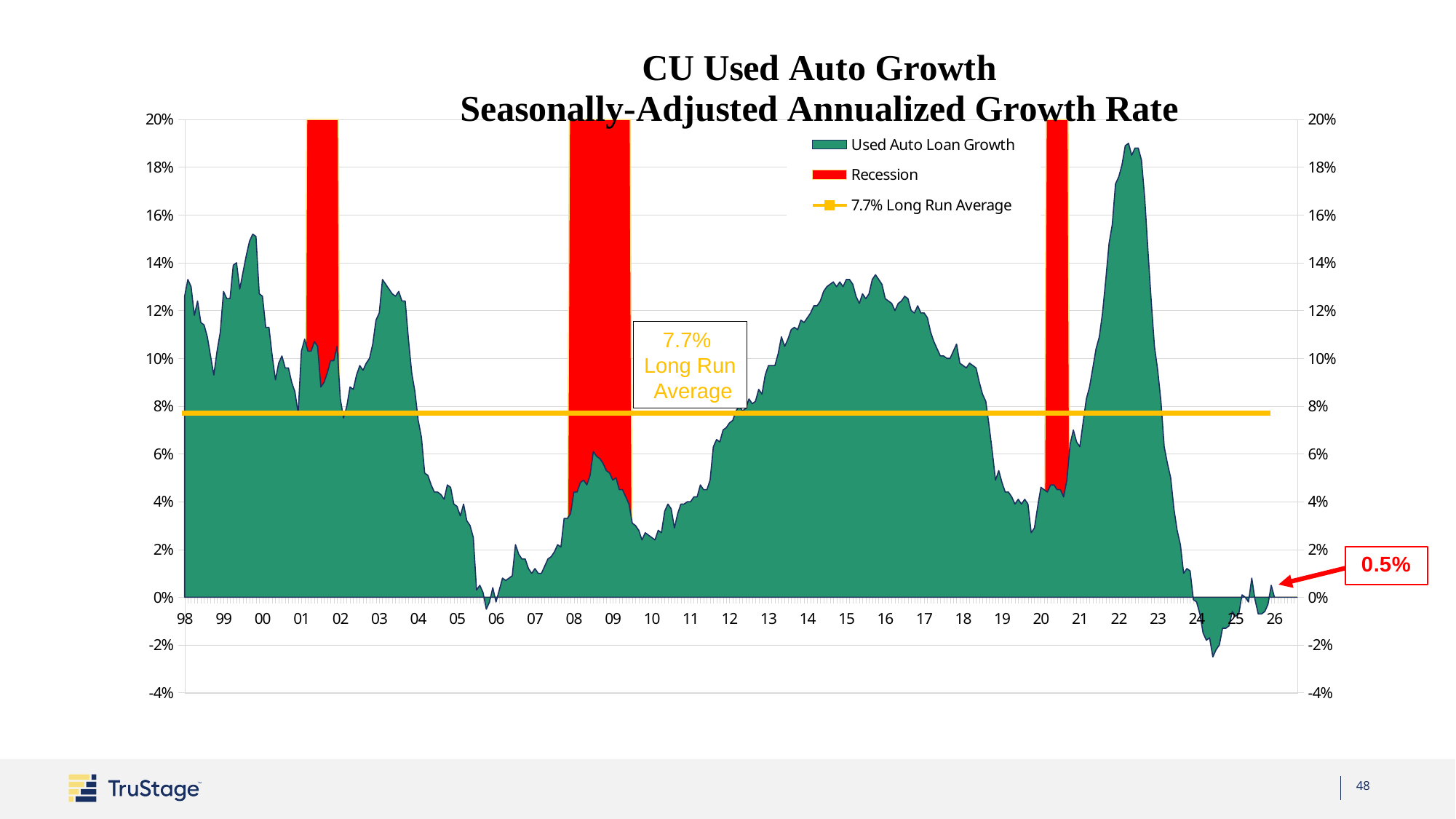
Is the lowest value of Used Auto Loan Growth in 2024 greater or less than 0%? less What kind of chart is used to show Used Auto Loan Growth? Area chart What is the most recent value labeled at the end of the Used Auto Loan Growth series? 0.5% Does Used Auto Loan Growth rise or fall between 2022 and 2024? Fall What is the long run average growth rate shown on the chart? 7.7% What is the title of the chart? CU Used Auto Growth Seasonally-Adjusted Annualized Growth Rate How many entries does the chart legend list? 3 In which year does Used Auto Loan Growth reach its highest peak? 22 Which is higher: the peak of Used Auto Loan Growth around 2022 or the peak around 2000? 2022 How many recession periods are shaded in red on the chart? 3 Is the peak value of Used Auto Loan Growth in 2022 greater or less than 16%? greater